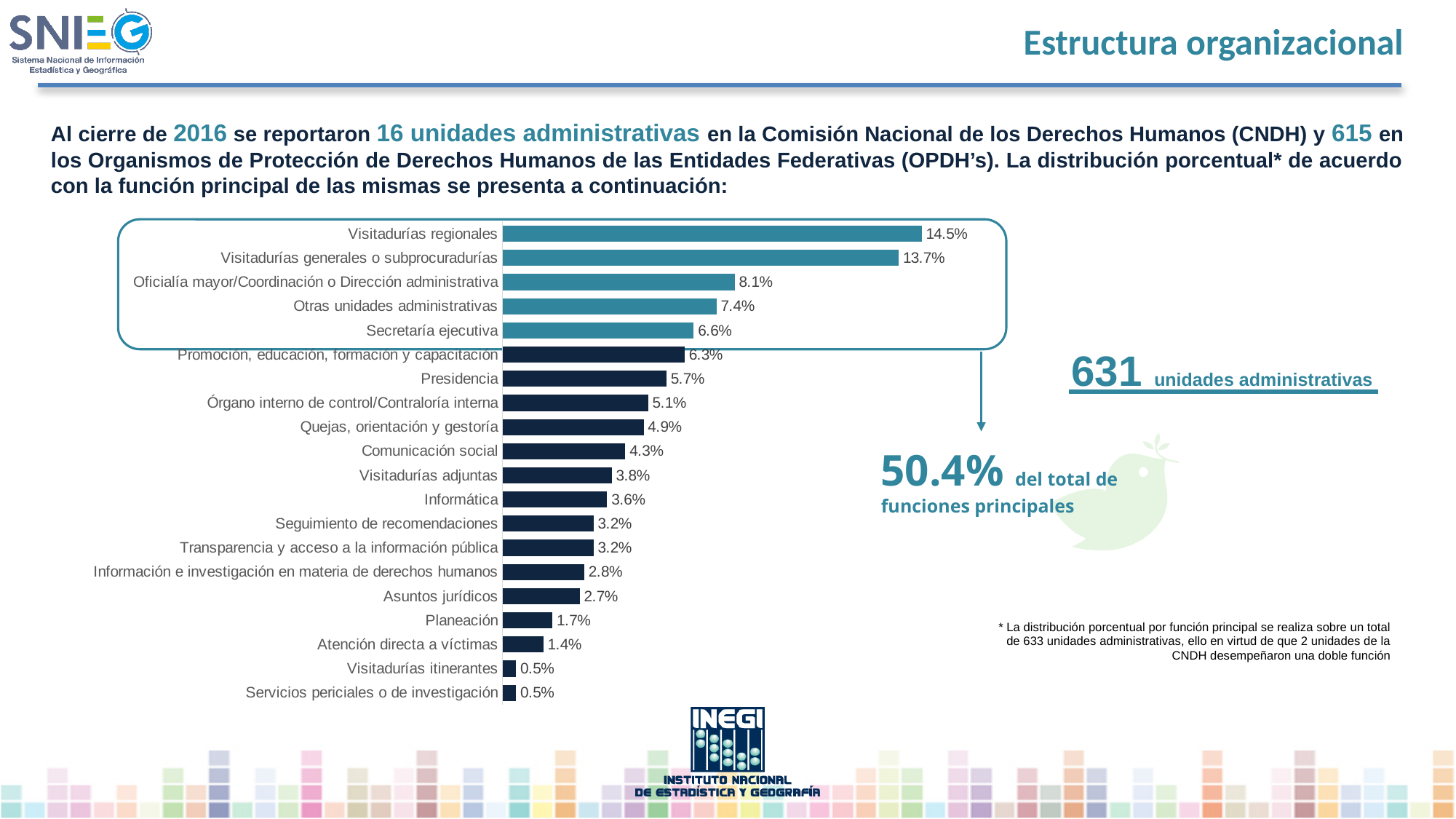
What percentage is shown for Informática? 3.6% How many categories are shown in the bar chart? 20 Which is larger, Comunicación social or Visitadurías adjuntas? Comunicación social What is the difference between Visitadurías regionales and Visitadurías generales o subprocuradurías? 0.8% Which is larger, Planeación or Asuntos jurídicos? Asuntos jurídicos What is the combined percentage of the five highlighted top categories, as stated on the slide? 50.4% Which category has the highest percentage? Visitadurías regionales What is the value for Presidencia? 5.7% What is the value for Atención directa a víctimas? 1.4% What kind of chart is shown on the slide? Bar chart What is the difference between Oficialía mayor/Coordinación o Dirección administrativa and Secretaría ejecutiva? 1.5% What percentage is shown for Visitadurías regionales? 14.5%